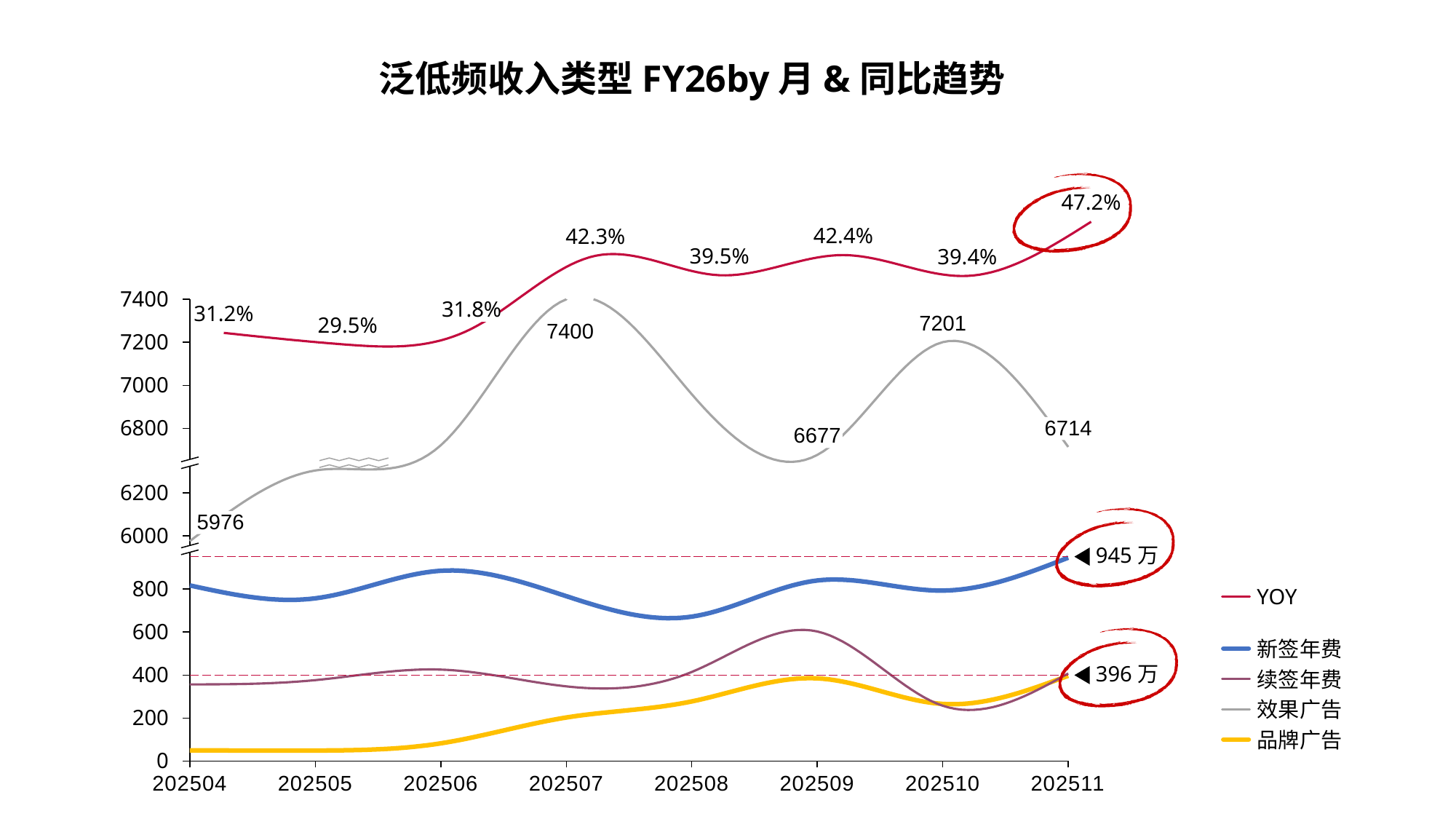
In which month is the YOY value highest? 202511 What is the value of 效果广告 for 202510? 7201 In which month is the YOY value lowest? 202505 Which is larger at 202511, 新签年费 or 续签年费? 新签年费 What is the value of 新签年费 for 202511? 945 万 What is the YOY value for 202511? 47.2% What is the difference between the 效果广告 values for 202507 and 202509? 723 What is the YOY value for 202507? 42.3% What is the value of 效果广告 for 202504? 5976 How many series does the legend list? 5 Is the value for 品牌广告 at 202504 greater or less than 200? less How many months are shown on the x axis? 8